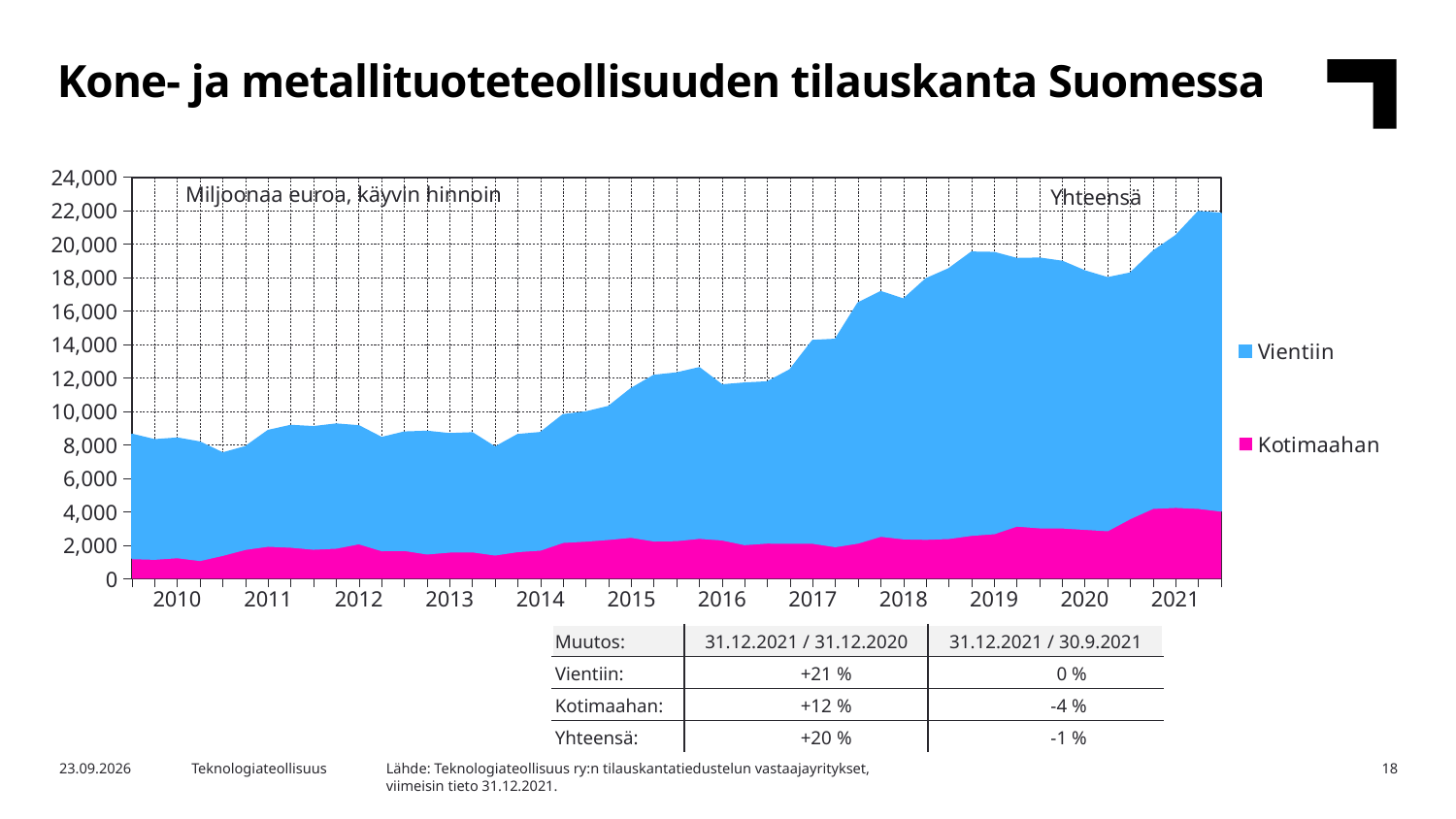
How many years are labelled on the x axis of the chart? 12 Is the Kotimaahan value at the start of 2010 greater or less than 2,000? less How many series does the chart legend list? 2 Is the total order backlog (Yhteensä) at the end of 2021 greater or less than 20,000? greater What unit is stated in the chart's subtitle? Miljoonaa euroa, käyvin hinnoin Is the total order backlog (Yhteensä) in 2016 greater or less than 14,000? less Does the total order backlog (Yhteensä) generally rise or fall from 2010 to 2021? rise What are the two series named in the chart legend? Vientiin and Kotimaahan Which series is larger throughout the chart, Vientiin or Kotimaahan? Vientiin What kind of chart is shown on the slide? Stacked area chart